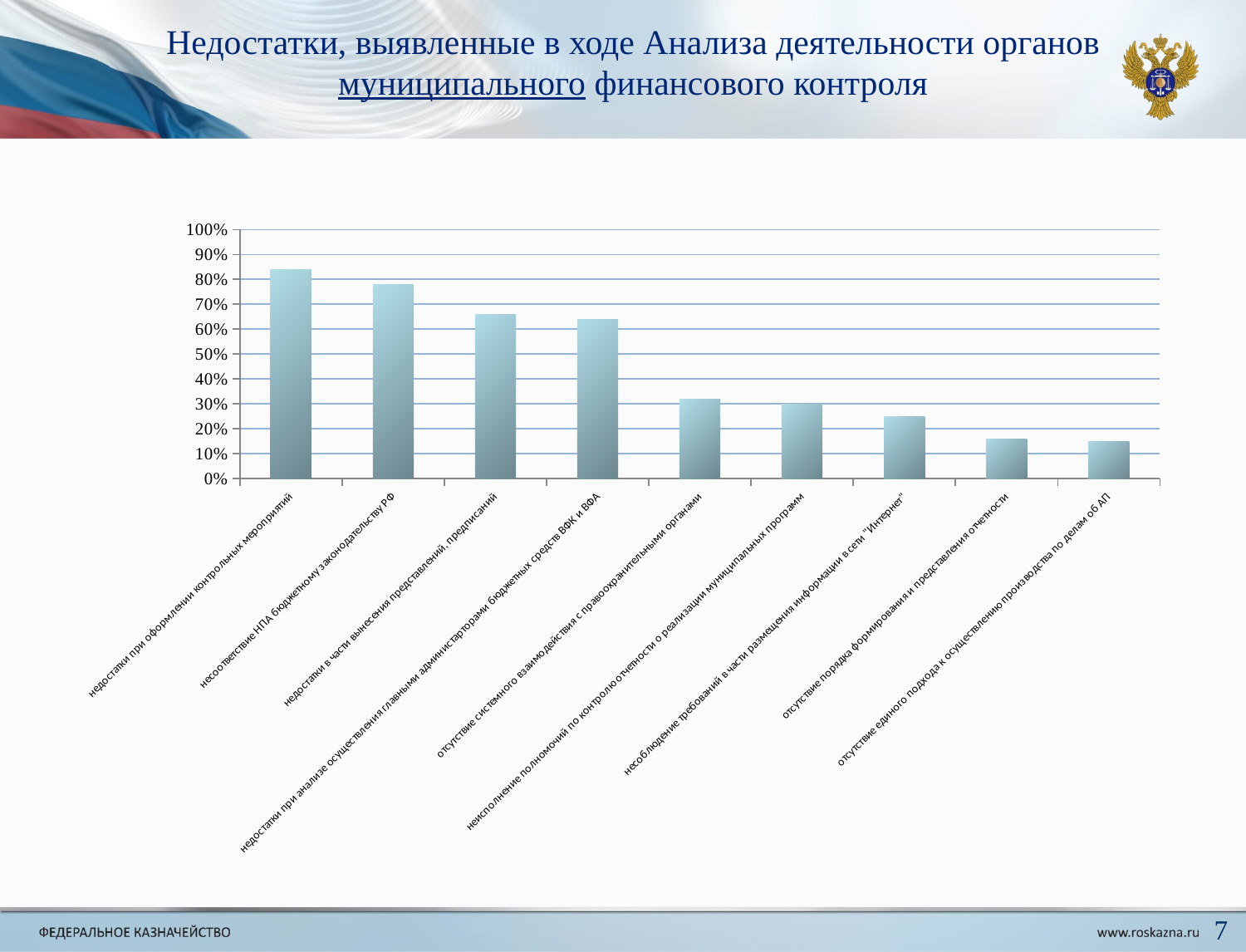
Is the value for "несоблюдение требований в части размещения информации в сети "Интернет"" greater or less than 20%? greater Is the value for "отсутствие системного взаимодействия с правоохранительными органами" greater or less than 40%? less Is the value for "несоответствие НПА бюджетному законодательству РФ" greater or less than 80%? less Do the bar values rise or fall from left to right along the x axis? fall What is the highest value shown on the vertical axis of the chart? 100% Which is larger: the value for "несоответствие НПА бюджетному законодательству РФ" or the value for "недостатки в части вынесения представлений, предписаний"? несоответствие НПА бюджетному законодательству РФ Which category has the highest value in the chart? недостатки при оформлении контрольных мероприятий What kind of chart is shown on the slide? bar chart How many categories (bars) does the chart show? 9